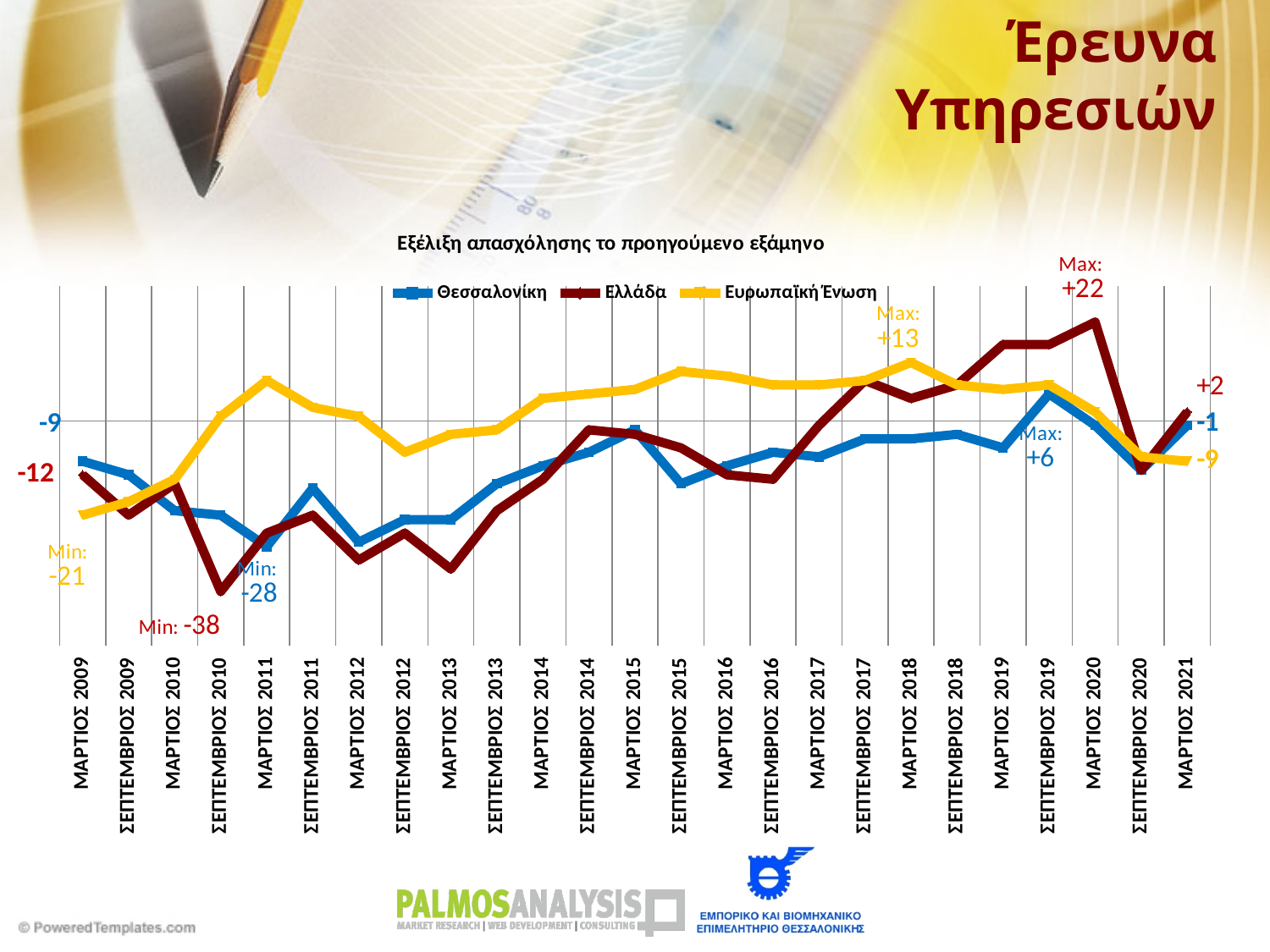
What is the difference between the labelled maximum (+22) and minimum (-38) of the Ελλάδα series? 60 What is the maximum value labelled for the Ευρωπαϊκή Ένωση series? +13 Which series reaches the highest labelled maximum value? Ελλάδα How many time points are plotted along the x axis? 25 What is the minimum value labelled for the Θεσσαλονίκη series? -28 At ΜΑΡΤΙΟΣ 2021, which is higher: Ελλάδα or Θεσσαλονίκη? Ελλάδα What kind of chart is shown on the slide? line chart What is the value for Ευρωπαϊκή Ένωση at ΜΑΡΤΙΟΣ 2021? -9 What is the title of the chart? Εξέλιξη απασχόλησης το προηγούμενο εξάμηνο How many series does the legend list? 3 What is the minimum value labelled for the Ελλάδα series? -38 What is the maximum value labelled for the Ελλάδα series? +22